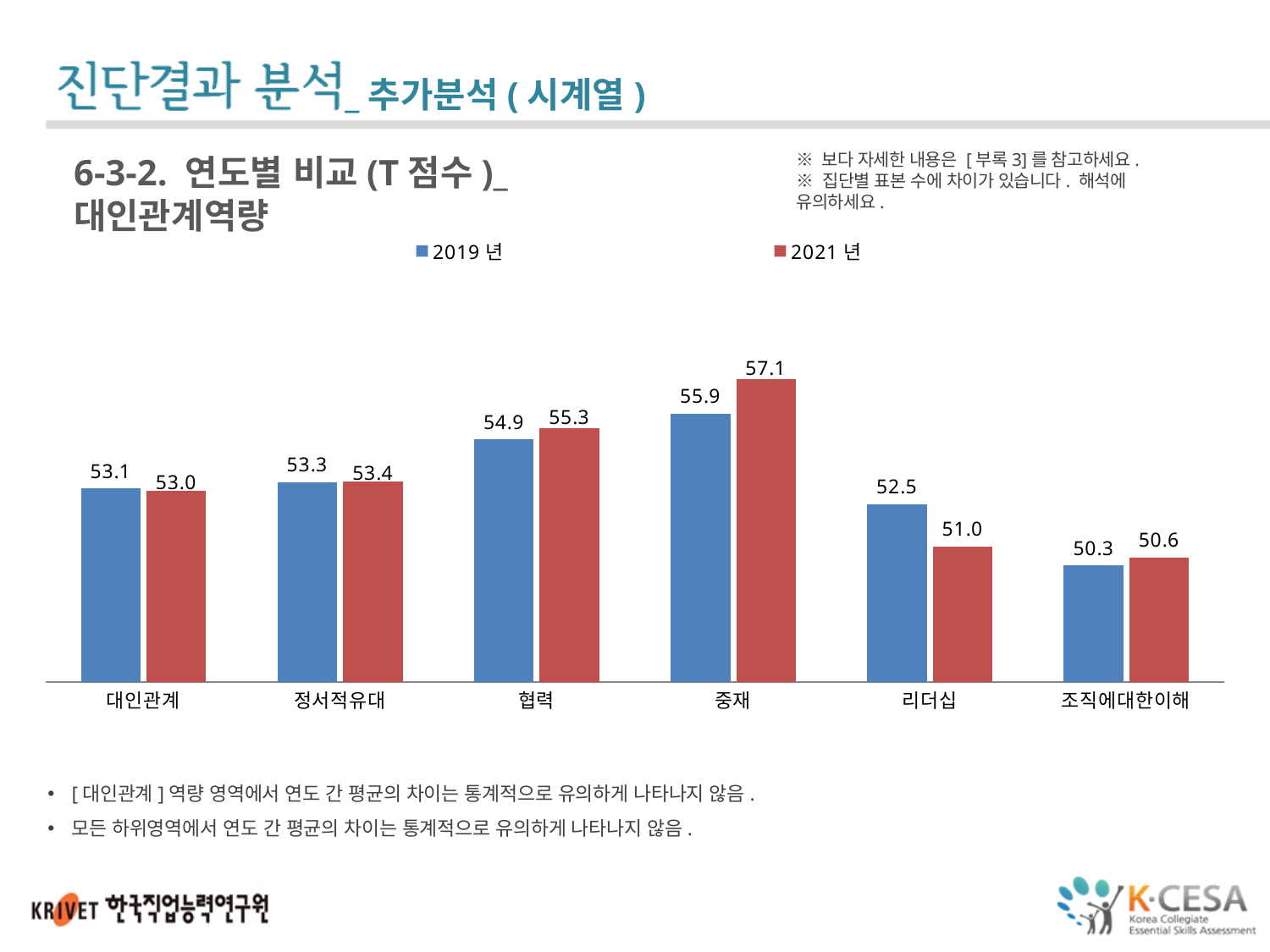
For 리더십, which is larger: the 2019년 value or the 2021년 value? 2019년 What kind of chart is shown on the slide? Bar chart What is the 2021년 value for 중재? 57.1 What is the 2019년 value for 협력? 54.9 How many categories are shown on the x axis of the chart? 6 Which category has the highest 2021년 value? 중재 Which category has the lowest 2019년 value? 조직에대한이해 What is the difference between the 2019년 and 2021년 values for 리더십? 1.5 What is the 2019년 value for 리더십? 52.5 For 협력, which is larger: the 2019년 value or the 2021년 value? 2021년 How many series does the chart legend list? 2 What is the difference between the 2021년 and 2019년 values for 중재? 1.2